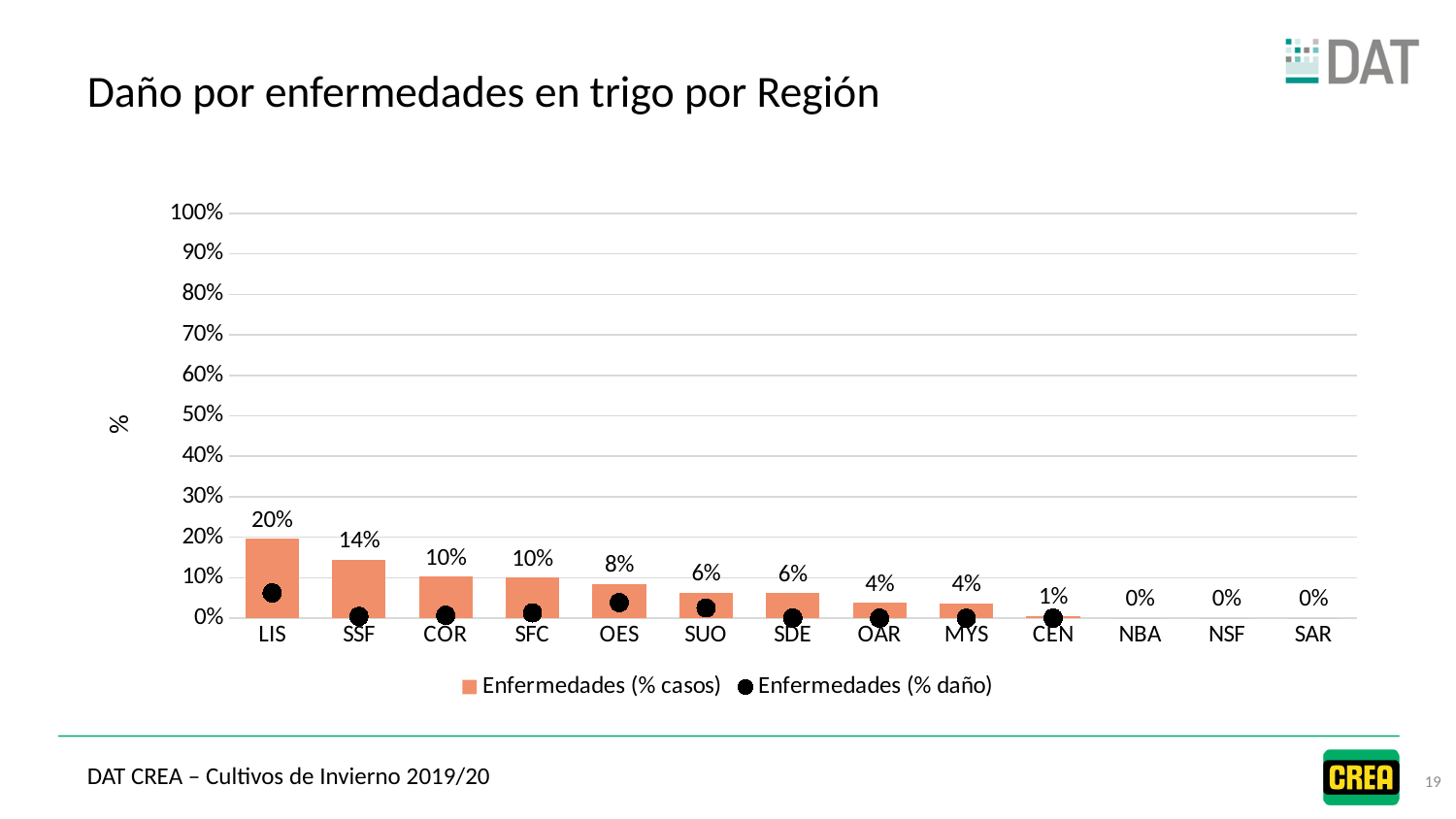
How many series does the legend list? 2 What is the difference between the Enfermedades (% casos) values for LIS and SSF? 6% Is the Enfermedades (% daño) value for LIS greater or less than 10%? less What is the value of Enfermedades (% casos) for LIS? 20% What kind of chart is shown on the slide? combination chart with bars and dot markers (bar and line chart) How many regions are shown on the x axis? 13 What is the value of Enfermedades (% casos) for OES? 8% What is the value of Enfermedades (% casos) for SSF? 14% What is the value of Enfermedades (% casos) for CEN? 1% Which region has the highest Enfermedades (% casos) value? LIS Do the Enfermedades (% casos) values rise or fall from left to right along the x axis? fall Which region has a larger Enfermedades (% casos) value, COR or OAR? COR